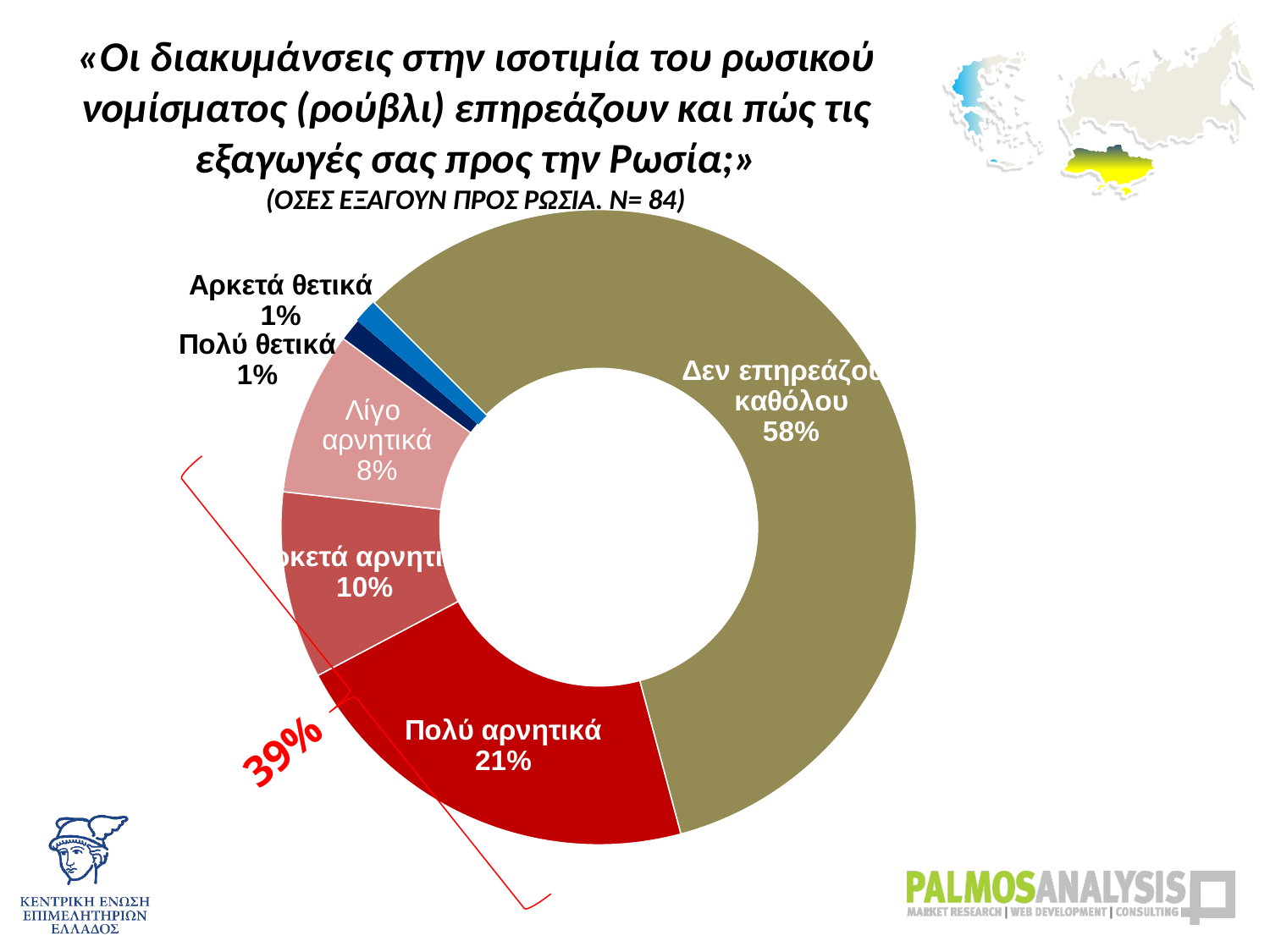
Which category has the largest share of the chart? Δεν επηρεάζουν καθόλου What kind of chart is shown on the slide? Doughnut (pie) chart How many categories are shown in the chart? 6 What combined percentage is highlighted in red next to the bracket grouping the negative responses? 39% What percentage is shown for "Πολύ αρνητικά"? 21% What share of respondents answered "Δεν επηρεάζουν καθόλου"? 58% Which is larger, the share for "Αρκετά αρνητικά" or the share for "Λίγο αρνητικά"? Αρκετά αρνητικά What is the difference in percentage points between "Δεν επηρεάζουν καθόλου" and "Πολύ αρνητικά"? 37 What is the sample size (N) stated under the chart title? 84 What percentage is shown for "Αρκετά αρνητικά"? 10% What percentage is shown for "Πολύ θετικά"? 1% What percentage is shown for "Λίγο αρνητικά"? 8%